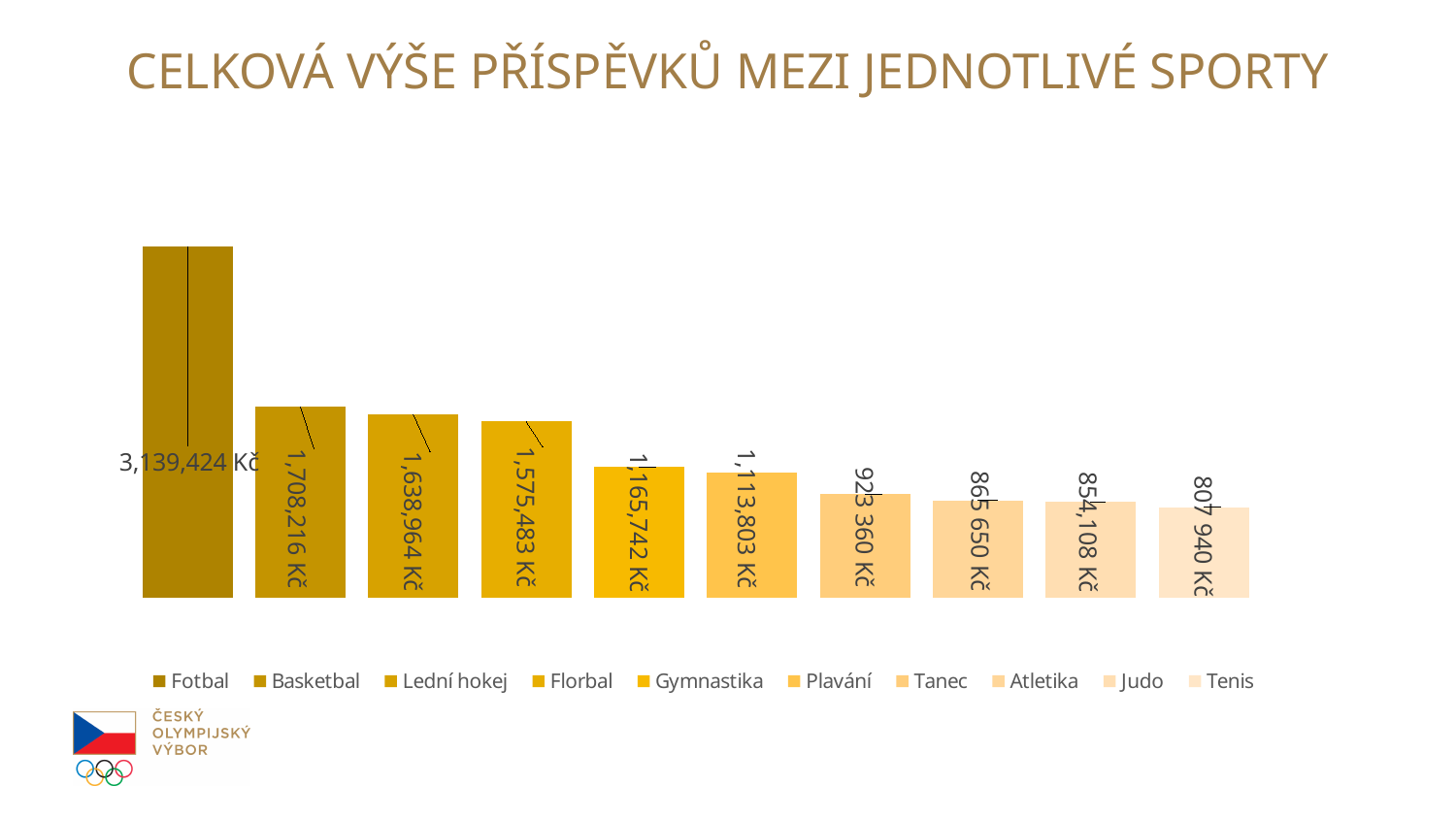
What is the value for Lední hokej? 1,638,964 Kč Which is larger, the value for Gymnastika or the value for Plavání? Gymnastika What is the value for Fotbal? 3,139,424 Kč Which sport received the highest total contribution? Fotbal What is the difference between the values for Basketbal and Lední hokej? 69,252 Kč Which sport received the lowest total contribution? Tenis How many sports are shown in the chart? 10 What is the value for Tenis? 807 940 Kč What is the value for Tanec? 923 360 Kč What is the difference between the values for Fotbal and Basketbal? 1,431,208 Kč What kind of chart is shown on the slide? Bar chart What is the title of the chart? CELKOVÁ VÝŠE PŘÍSPĚVKŮ MEZI JEDNOTLIVÉ SPORTY